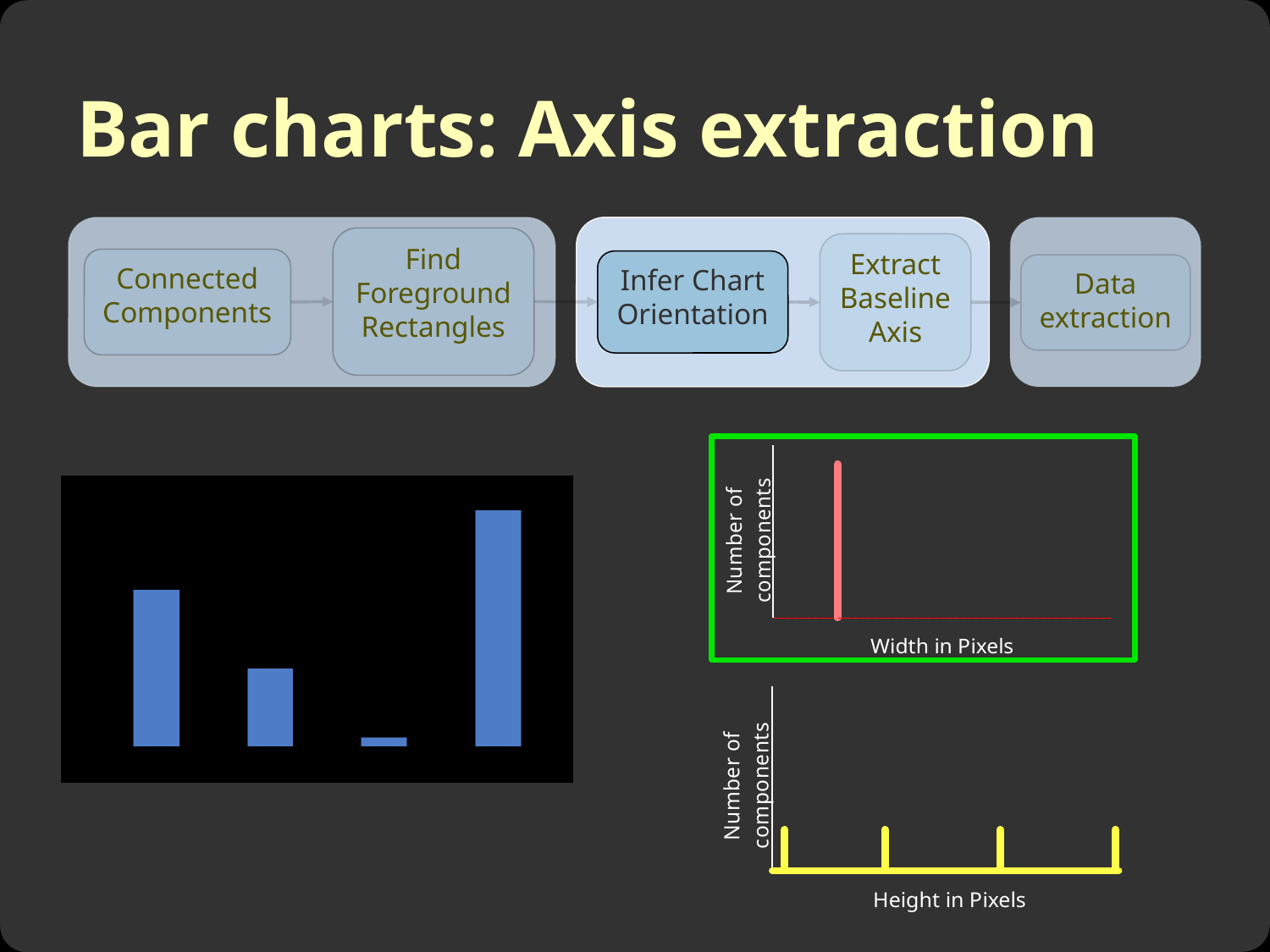
How many bars are plotted in the bottom-right chart (Height in Pixels)? 4 What kind of chart is the black-background chart on the left of the slide? bar chart In the black-background bar chart on the left, which bar is the tallest, counting from the left? the fourth bar In the black-background bar chart on the left, is the second bar or the fourth bar taller? the fourth bar How many bars are plotted in the chart inside the green box (Width in Pixels)? 1 How many bars does the black-background bar chart on the left show? 4 What is the x-axis label of the chart inside the green box on the right? Width in Pixels What colour are the bars in the black-background bar chart on the left? blue In the black-background bar chart on the left, is the first bar or the second bar taller? the first bar In the black-background bar chart on the left, which bar is the shortest, counting from the left? the third bar What is the y-axis label of the bottom-right chart with the yellow bars? Number of components